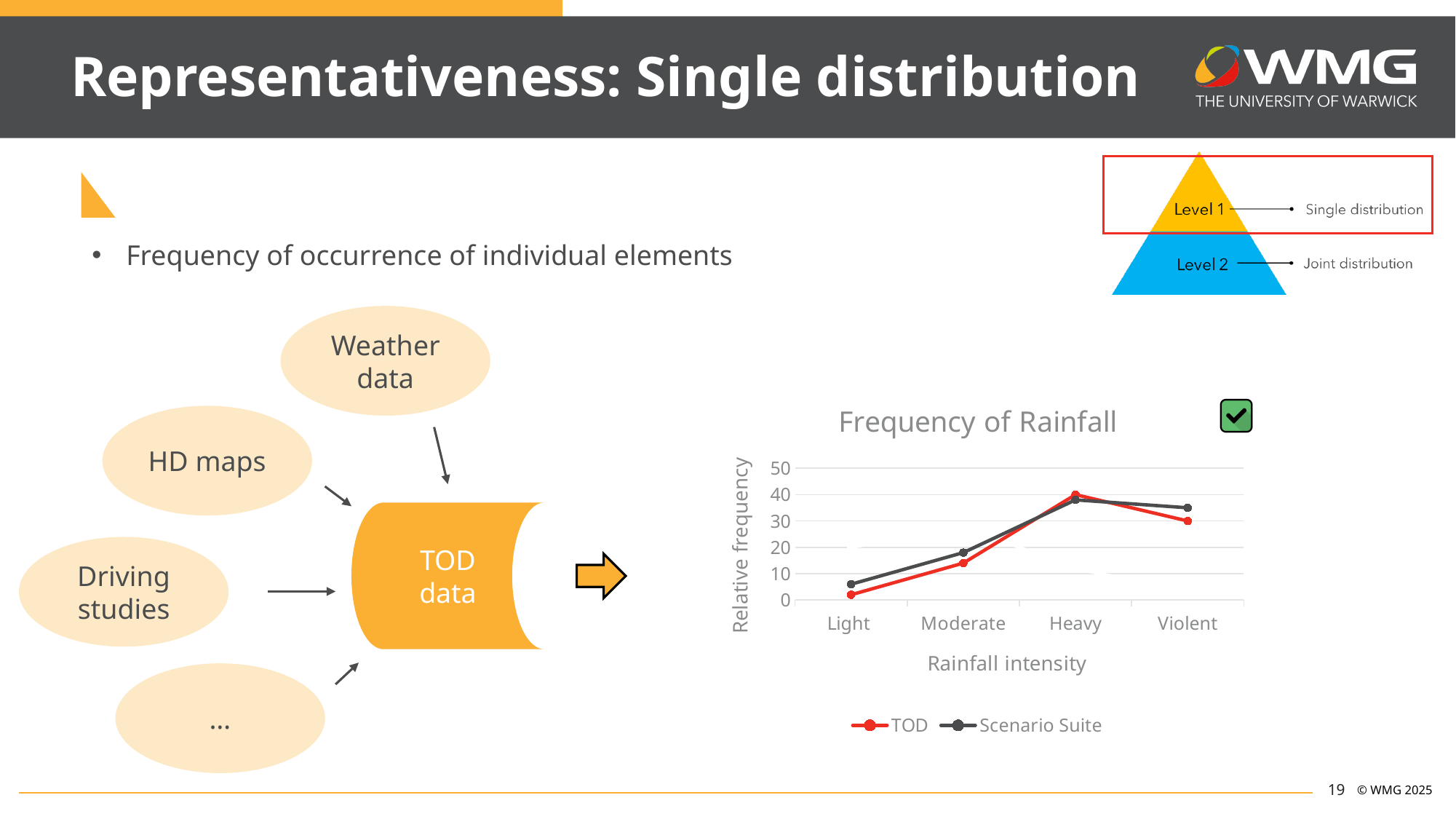
What is the y-axis label of the "Frequency of Rainfall" chart? Relative frequency In the "Frequency of Rainfall" chart, is the TOD value for Light greater or less than 10? less In the "Frequency of Rainfall" chart, is the TOD value for Heavy greater or less than 30? greater How many rainfall intensity categories are shown on the x axis of the "Frequency of Rainfall" chart? 4 In the "Frequency of Rainfall" chart, which series has the larger value for Violent, TOD or Scenario Suite? Scenario Suite In the "Frequency of Rainfall" chart, which series is drawn in red? TOD How many series does the legend of the "Frequency of Rainfall" chart list? 2 In the "Frequency of Rainfall" chart, at which rainfall intensity is the TOD series highest? Heavy In the "Frequency of Rainfall" chart, at which rainfall intensity is the TOD series lowest? Light What kind of chart is the "Frequency of Rainfall" chart? line chart In the "Frequency of Rainfall" chart, is the Scenario Suite value for Moderate greater or less than 20? less In the "Frequency of Rainfall" chart, does the TOD series rise or fall from Light to Heavy? rise